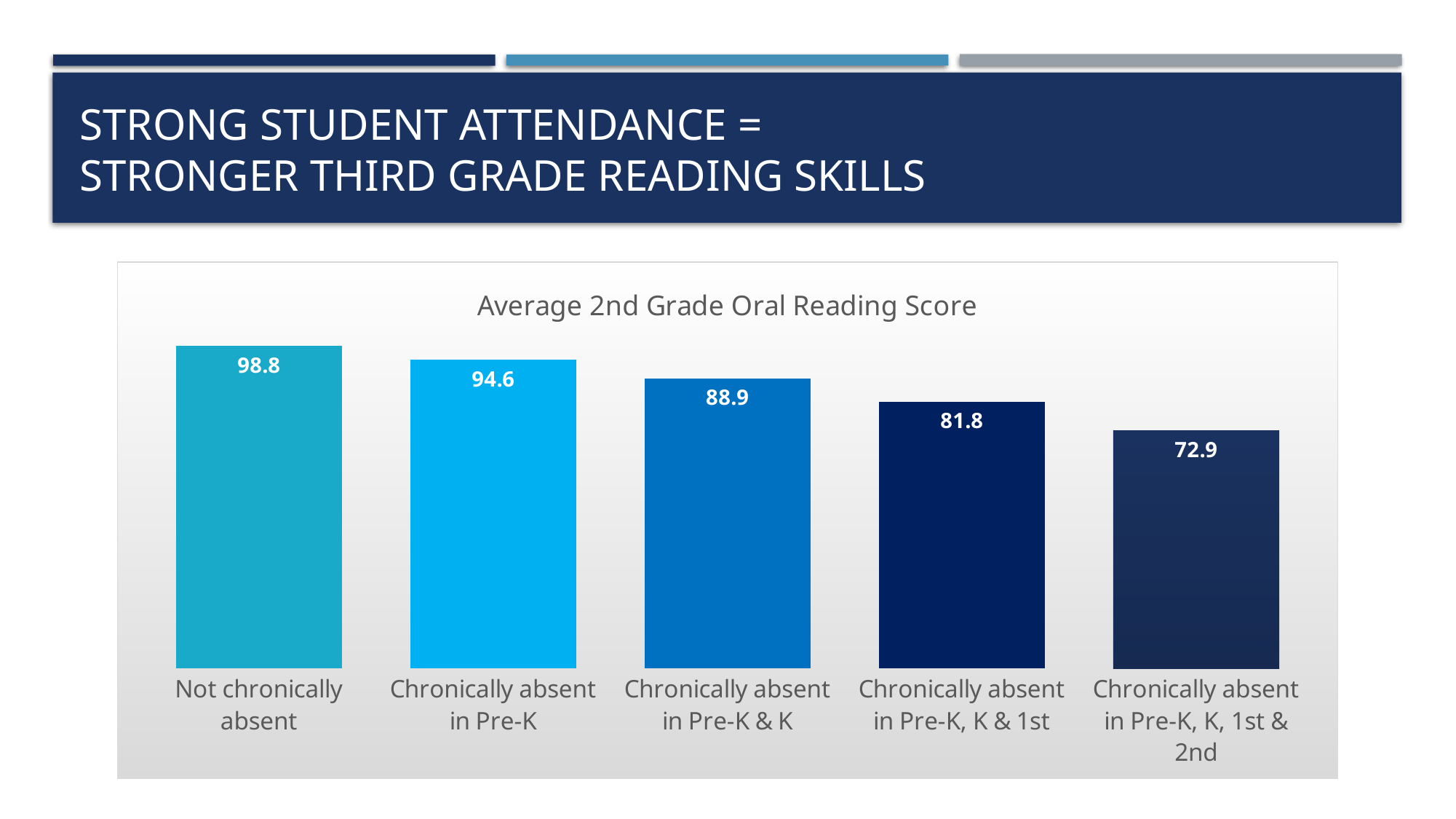
What kind of chart is shown on the slide? Bar chart What is the difference between the scores for 'Not chronically absent' and 'Chronically absent in Pre-K, K, 1st & 2nd'? 25.9 What is the average 2nd grade oral reading score for students chronically absent in Pre-K, K & 1st? 81.8 What is the title of the chart? Average 2nd Grade Oral Reading Score Which category has the highest average 2nd grade oral reading score? Not chronically absent Do the scores rise or fall moving from left to right across the categories? Fall What is the average 2nd grade oral reading score for students chronically absent in Pre-K & K? 88.9 What is the average 2nd grade oral reading score for students who were not chronically absent? 98.8 What is the difference between the scores for 'Chronically absent in Pre-K' and 'Chronically absent in Pre-K & K'? 5.7 Which has a higher score: 'Chronically absent in Pre-K' or 'Chronically absent in Pre-K, K & 1st'? Chronically absent in Pre-K Which category has the lowest average 2nd grade oral reading score? Chronically absent in Pre-K, K, 1st & 2nd How many categories are shown in the chart? 5